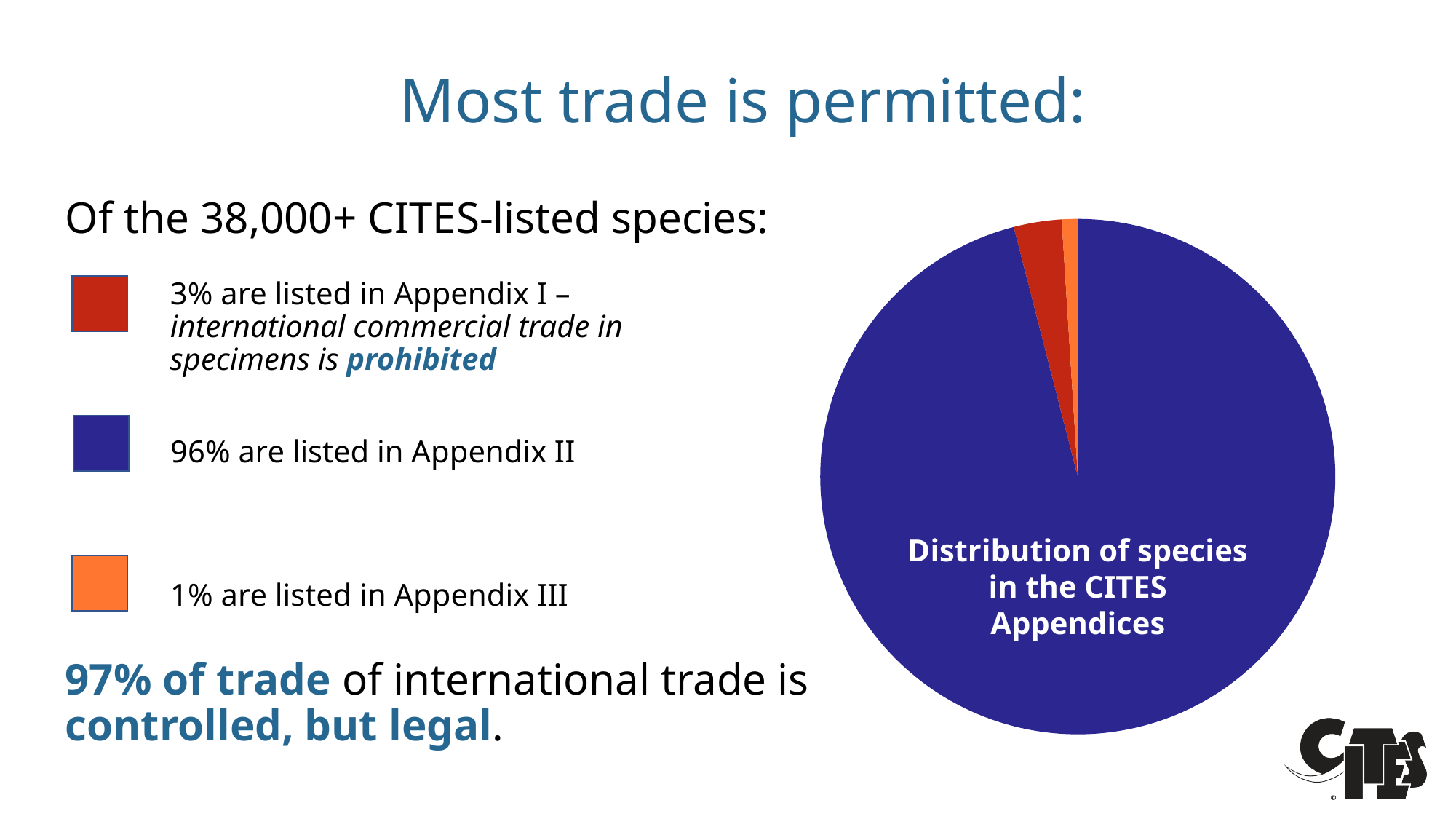
Which Appendix has the smallest share of the pie? Appendix III What colour is the slice representing Appendix II? dark blue What percentage of CITES-listed species are listed in Appendix III? 1% What is the title of the pie chart? Distribution of species in the CITES Appendices What percentage of CITES-listed species are listed in Appendix II? 96% Which Appendix has the largest share of the pie? Appendix II What is the combined share of species listed in Appendix I and Appendix III? 4% What percentage of CITES-listed species are listed in Appendix I? 3% What kind of chart is shown on the slide? pie chart What is the difference in percentage points between the Appendix II share and the Appendix I share? 93 How many slices does the pie chart have? 3 Which is larger, the share for Appendix I or the share for Appendix III? Appendix I